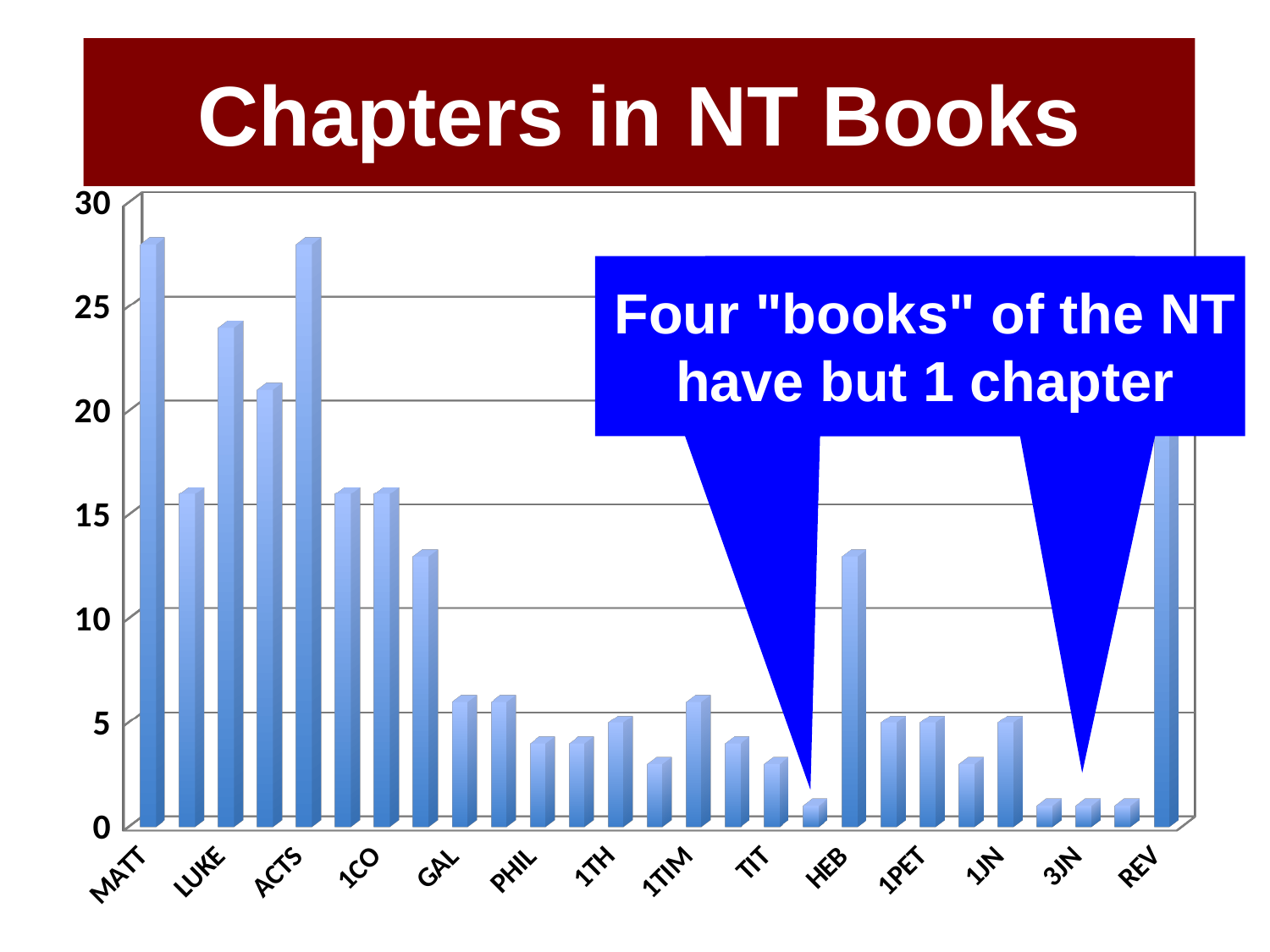
Is the value for 3JN greater or less than 5? less Which has the larger value, MATT or LUKE? MATT What does the blue callout on the chart say? Four "books" of the NT have but 1 chapter Is the value for MATT greater or less than 25? greater What kind of chart is shown on the slide? bar chart What is the title of the chart? Chapters in NT Books Is the value for GAL greater or less than 10? less How many category labels are shown on the x axis? 14 Which has the larger value, HEB or GAL? HEB